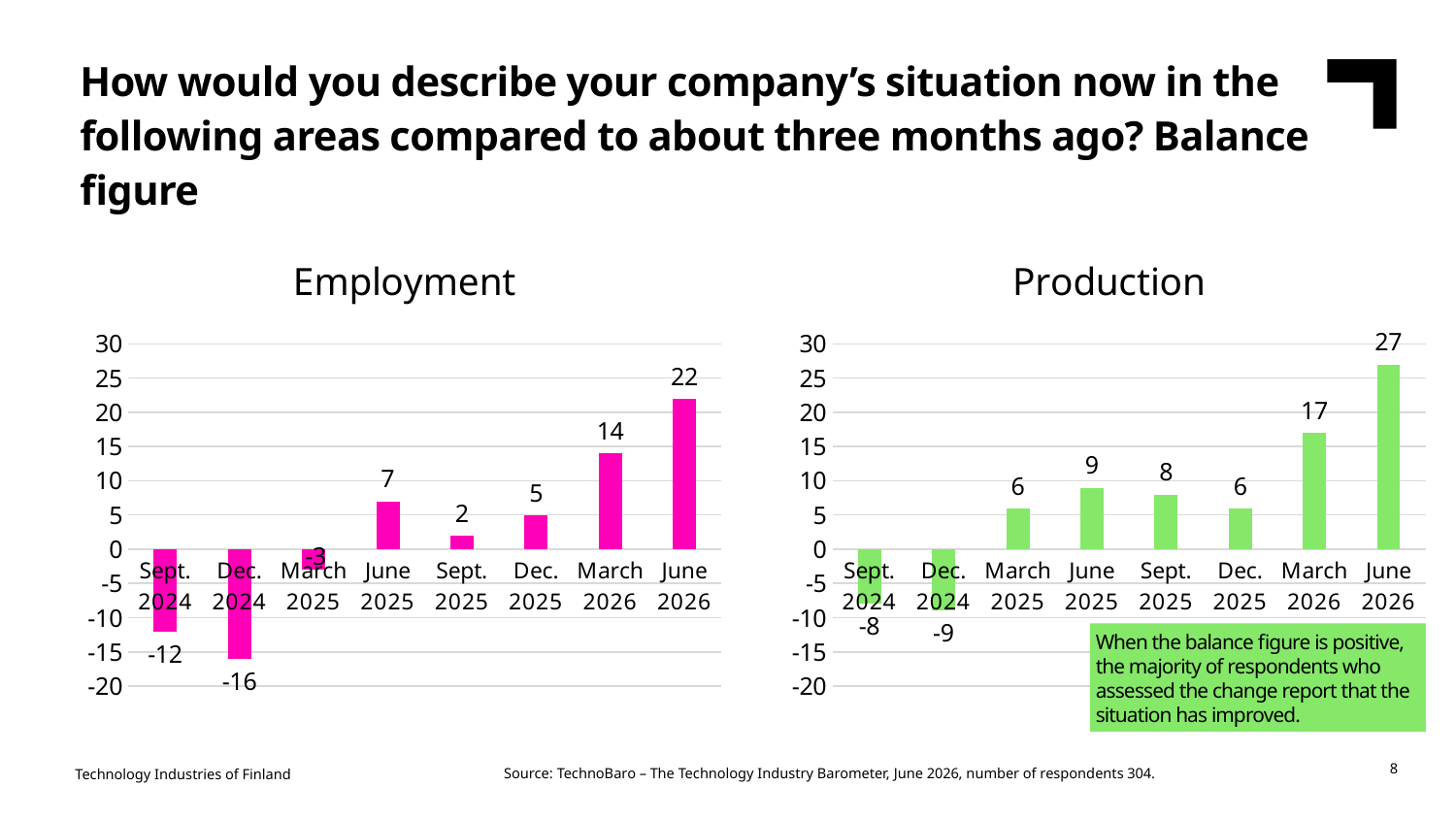
In the Employment chart, what is the balance figure for Dec. 2024? -16 What colour are the bars in the Production chart? green How many periods are shown on the x axis of the Production chart? 8 In the Production chart, what is the difference between the June 2026 and March 2026 balance figures? 10 In the Employment chart, which is larger: the balance figure for June 2025 or Sept. 2025? June 2025 In the Employment chart, which period has the lowest balance figure? Dec. 2024 In the Production chart, which period has the highest balance figure? June 2026 In the Production chart, what is the balance figure for Sept. 2024? -8 In the Employment chart, what is the balance figure for June 2026? 22 What type of chart is the Employment chart? bar chart In the Production chart, do the balance figures generally rise or fall from Sept. 2024 to June 2026? rise In the Production chart, what is the balance figure for March 2026? 17